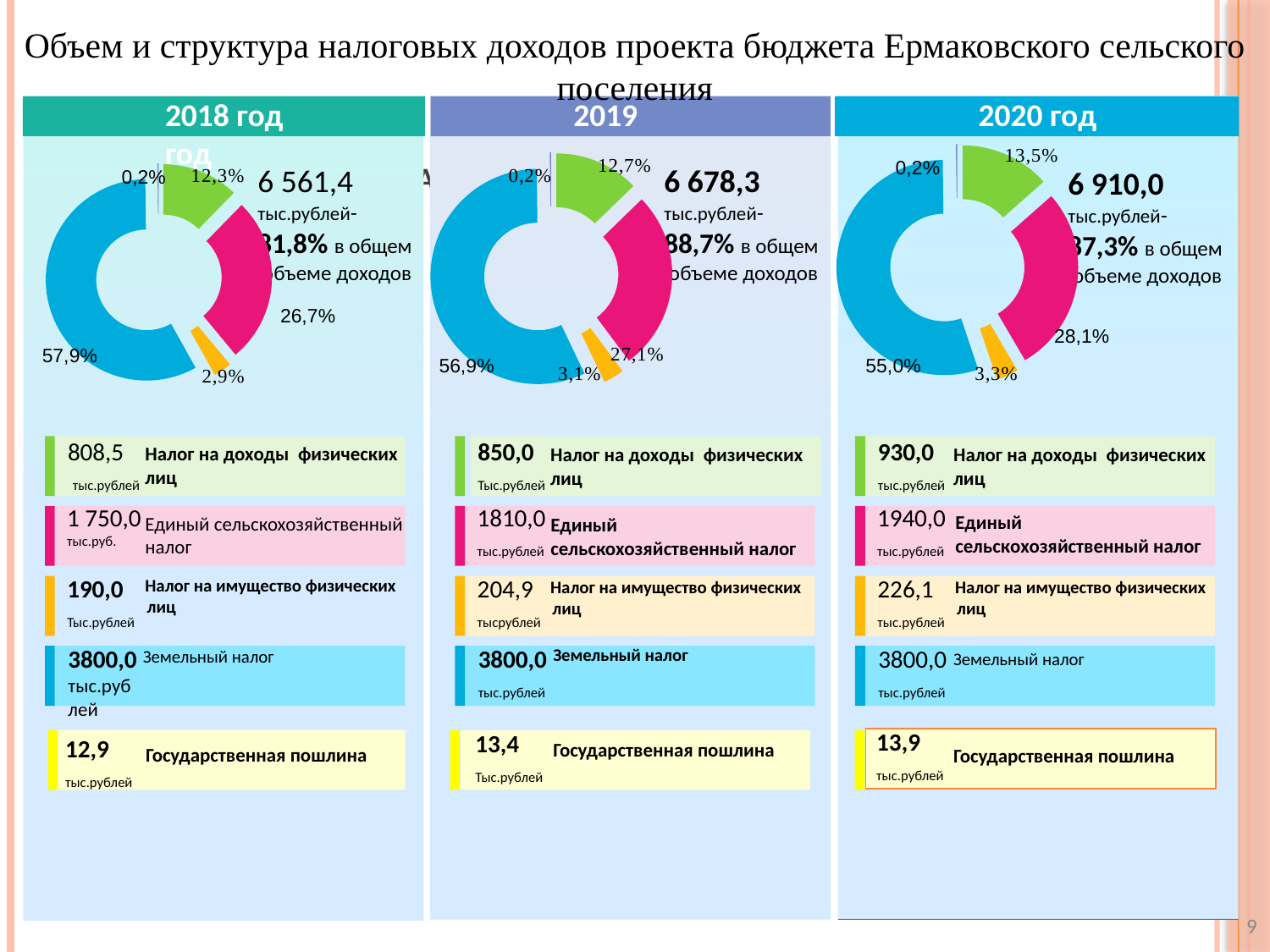
In the 2018 год chart, which slice is the smallest? Государственная пошлина (0,2%) What total value in тыс.рублей is printed next to the 2020 год chart? 6 910,0 What is the difference between the pink slice share in the 2020 год chart (28,1%) and in the 2018 год chart (26,7%)? 1,4 percentage points What type of chart is used for each year on the slide? Donut (pie) chart How many slices does each donut chart on the slide have? 5 In the 2018 год chart, what share does the largest slice (Земельный налог, blue) have? 57,9% In the 2020 год chart, what percentage is shown for the pink slice (Единый сельскохозяйственный налог)? 28,1% In the 2020 год chart, what percentage is shown for the orange slice (Налог на имущество физических лиц)? 3,3% How does the share of the blue slice (Земельный налог) change from the 2018 chart to the 2020 chart? It falls (57,9% to 55,0%) In the 2019 год chart, what percentage is shown for the green slice (Налог на доходы физических лиц)? 12,7% In the 2019 год chart, which slice is the largest? Земельный налог (56,9%) Which is larger in the 2019 год chart: the green slice (12,7%) or the orange slice (3,1%)? The green slice (12,7%)